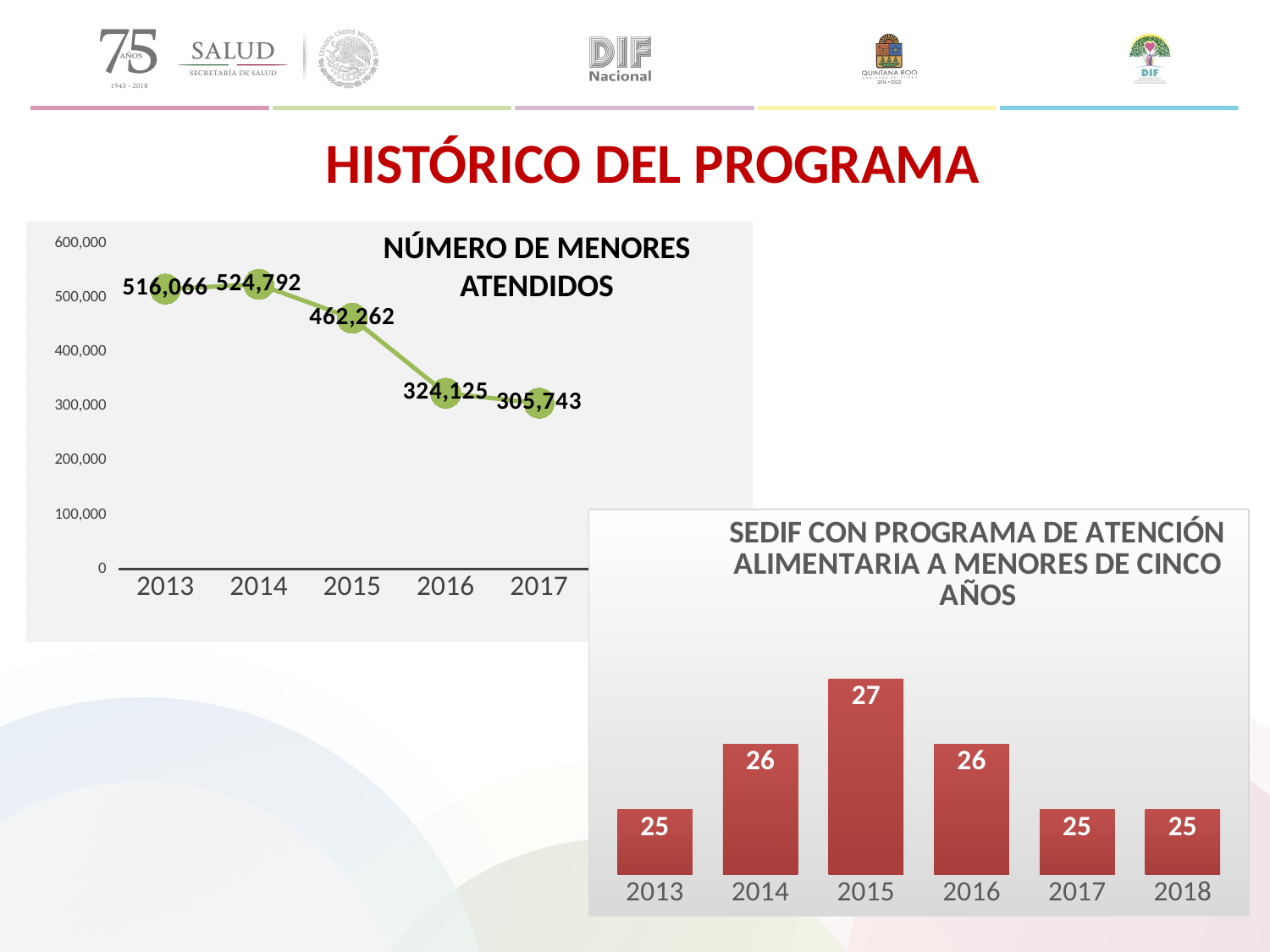
How many years are plotted in the 'NÚMERO DE MENORES ATENDIDOS' chart? 5 What kind of chart is 'SEDIF CON PROGRAMA DE ATENCIÓN ALIMENTARIA A MENORES DE CINCO AÑOS'? bar chart In the 'NÚMERO DE MENORES ATENDIDOS' chart, what is the value for 2015? 462,262 What kind of chart is 'NÚMERO DE MENORES ATENDIDOS'? line chart In the 'NÚMERO DE MENORES ATENDIDOS' chart, what is the difference between the 2013 and 2014 values? 8,726 In the 'NÚMERO DE MENORES ATENDIDOS' chart, do the values generally rise or fall from 2014 to 2017? fall In the 'NÚMERO DE MENORES ATENDIDOS' chart, which year has the lowest value? 2017 In the 'SEDIF CON PROGRAMA DE ATENCIÓN ALIMENTARIA A MENORES DE CINCO AÑOS' chart, which year has the highest value? 2015 In the 'SEDIF CON PROGRAMA DE ATENCIÓN ALIMENTARIA A MENORES DE CINCO AÑOS' chart, what is the value for 2015? 27 In the 'NÚMERO DE MENORES ATENDIDOS' chart, what is the value for 2017? 305,743 In the 'SEDIF CON PROGRAMA DE ATENCIÓN ALIMENTARIA A MENORES DE CINCO AÑOS' chart, how many years are shown? 6 In the 'NÚMERO DE MENORES ATENDIDOS' chart, which year has the highest value? 2014